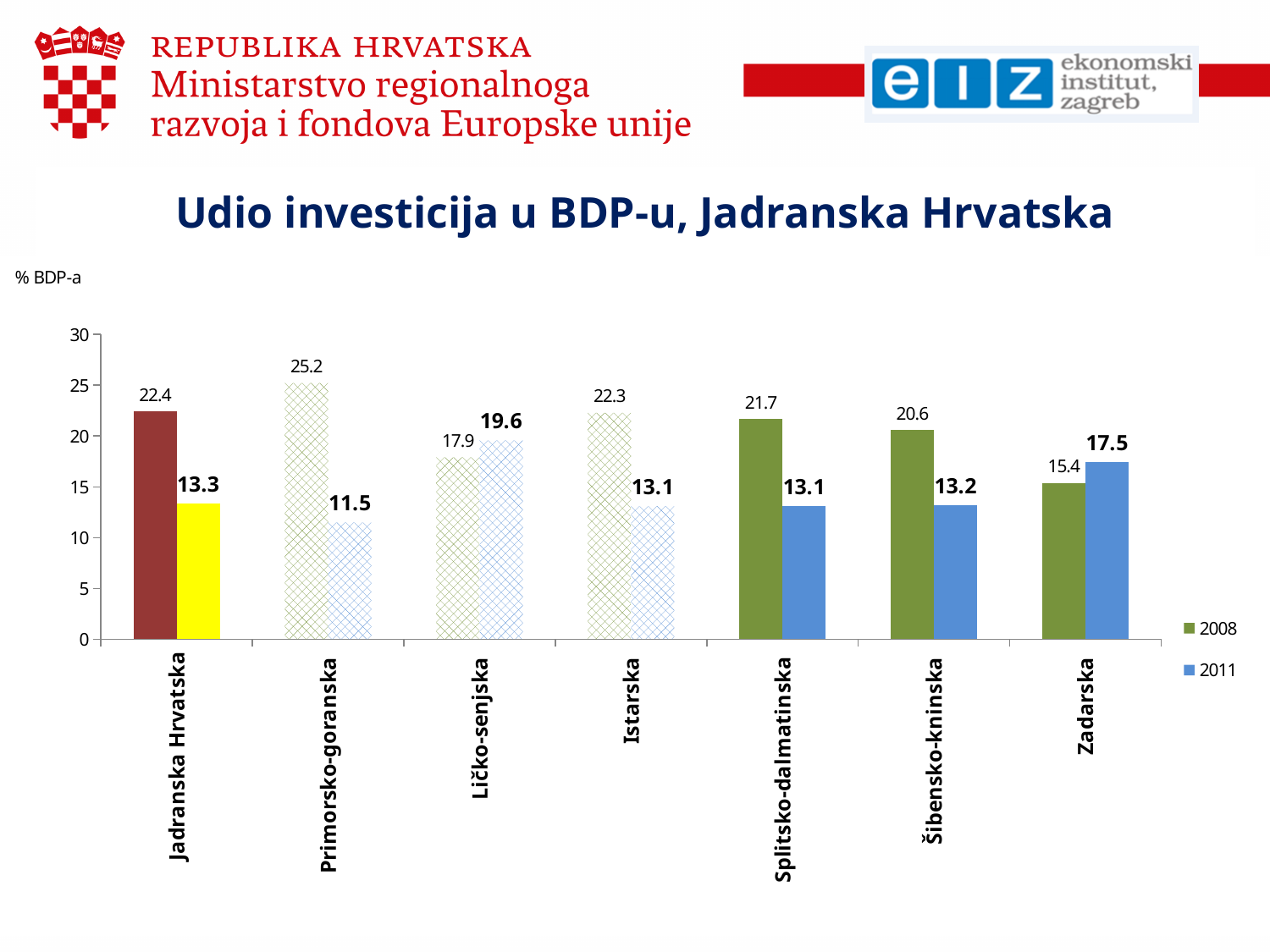
What is the difference between the 2008 and 2011 values for Istarska? 9.2 What kind of chart is shown on the slide? bar chart What is the 2011 value for Ličko-senjska? 19.6 Which category has the highest 2008 value? Primorsko-goranska Which is larger for Ličko-senjska, the 2008 value or the 2011 value? 2011 How many series does the legend list? 2 What is the 2011 value for Jadranska Hrvatska? 13.3 What is the title of the chart? Udio investicija u BDP-u, Jadranska Hrvatska What is the 2008 value for Zadarska? 15.4 Which category has the lowest 2011 value? Primorsko-goranska How many categories are shown on the x axis? 7 What is the 2008 value for Primorsko-goranska? 25.2